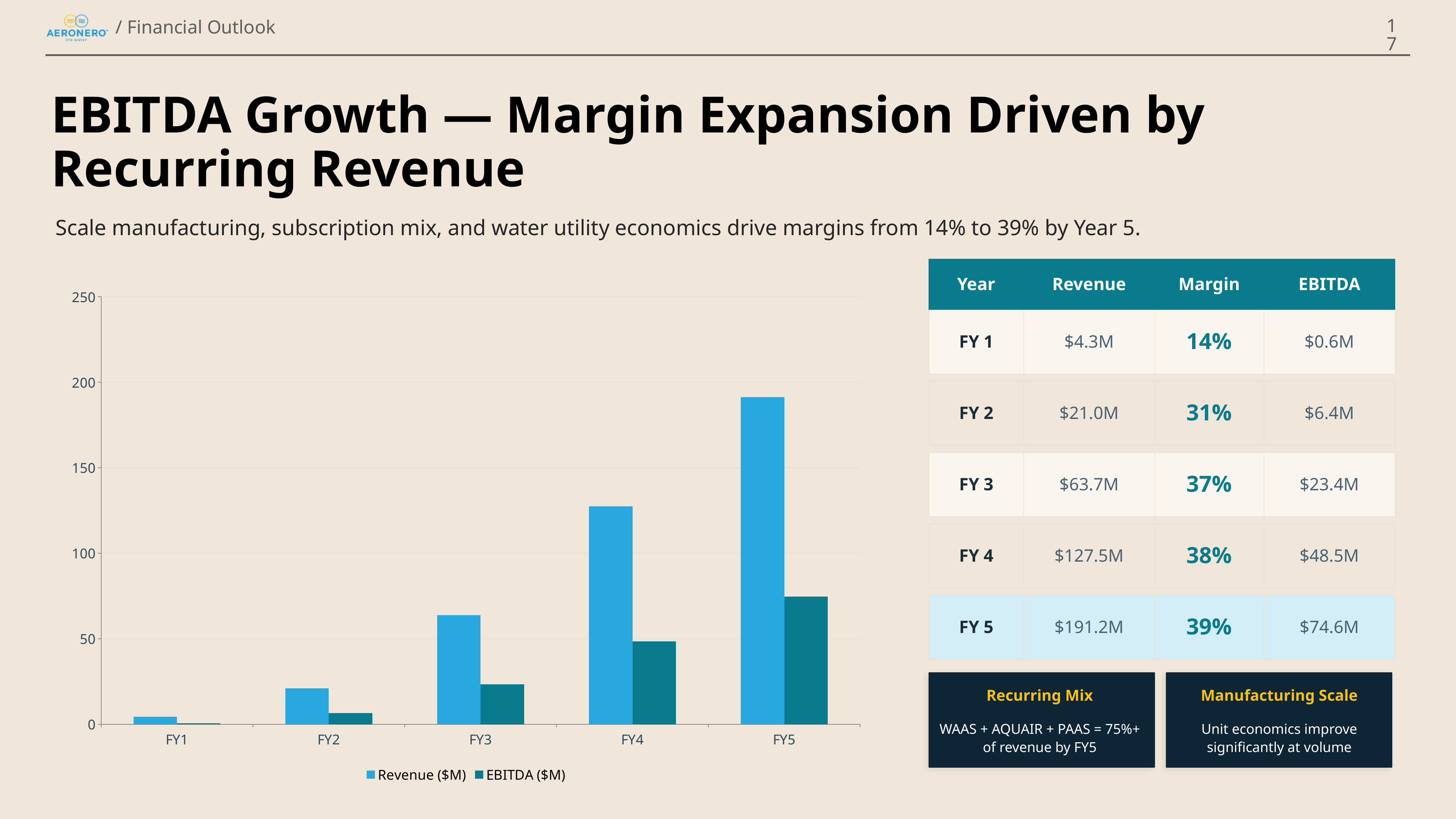
How many series does the chart legend list? 2 Is the Revenue ($M) value for FY5 greater or less than 150? greater Is the EBITDA ($M) value for FY3 greater or less than 50? less Which fiscal year has the highest Revenue ($M) bar? FY5 What kind of chart is shown on the slide? Bar chart Is the Revenue ($M) value for FY4 greater or less than 100? greater What are the two legend entries of the chart? Revenue ($M) and EBITDA ($M) Which fiscal year has the lowest EBITDA ($M) bar? FY1 How many fiscal years are shown on the x axis of the chart? 5 Do the Revenue ($M) bars rise or fall from FY1 to FY5? Rise Which is larger in FY3: the Revenue ($M) bar or the EBITDA ($M) bar? Revenue ($M) According to the slide, what is the Revenue for FY 5? $191.2M